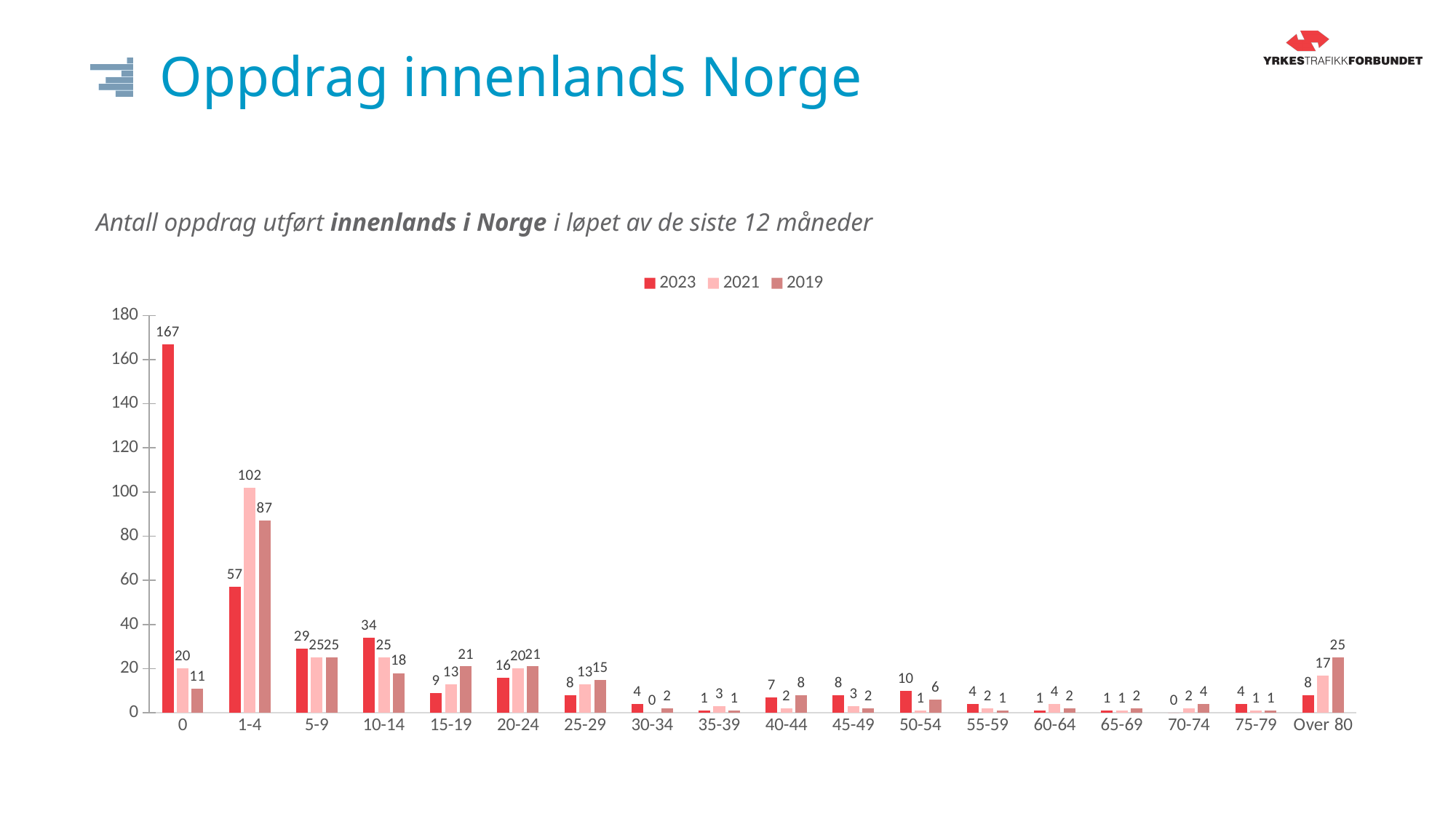
What is the value for the 2019 series in the "Over 80" category? 25 What kind of chart is shown on the slide? bar chart Which category has the lowest value for the 2023 series? 70-74 What is the value for the 2023 series in the "0" category? 167 What is the difference between the 2021 and 2019 values in the "1-4" category? 15 How many series does the legend list? 3 Which category has the highest value for the 2019 series? 1-4 Is the value for 2023 in the "0" category greater or less than 160? greater How many categories are shown on the x axis? 18 What is the value for the 2021 series in the "1-4" category? 102 What is the value for the 2021 series in the "30-34" category? 0 Which is larger in the "10-14" category: the 2023 value or the 2019 value? 2023